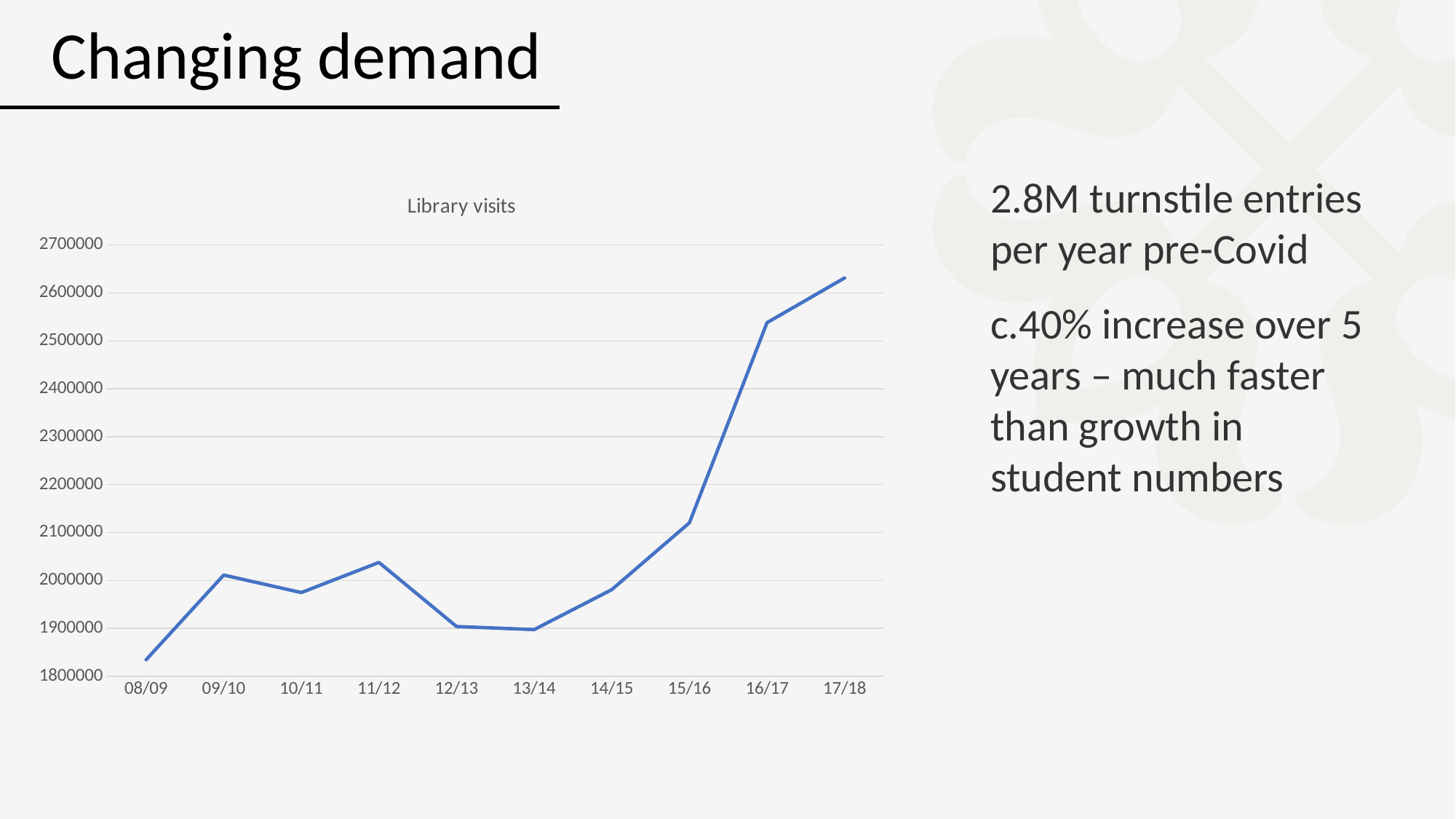
Is the value for 08/09 greater or less than 1900000? less Which year has more library visits, 16/17 or 15/16? 16/17 Which year has more library visits, 11/12 or 12/13? 11/12 What is the title of the chart? Library visits Do library visits rise or fall from 15/16 to 17/18? Rise How many academic years are plotted on the x axis of the chart? 10 What kind of chart is shown on the slide? Line chart Is the value for 16/17 greater or less than 2500000? greater Which year has the highest number of library visits? 17/18 Is the value for 17/18 greater or less than 2600000? greater Which year has the lowest number of library visits? 08/09